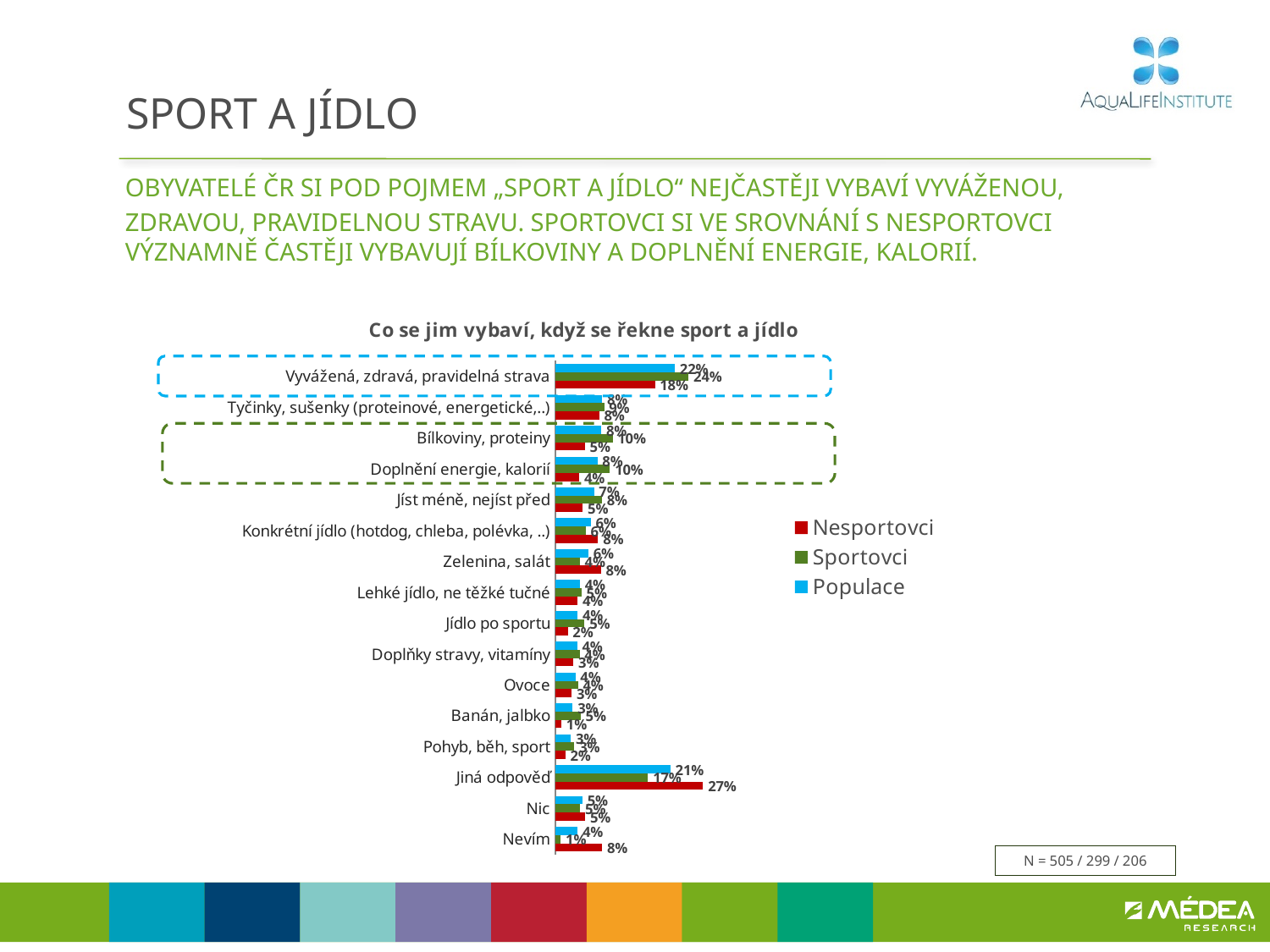
What is the Sportovci value for "Vyvážená, zdravá, pravidelná strava"? 24% What is the Nesportovci value for "Nevím"? 8% How many categories are plotted on the chart? 16 What is the Nesportovci value for "Jiná odpověď"? 27% What is the difference between the Nesportovci and Sportovci values for "Jiná odpověď"? 10% Which category has the highest Nesportovci value? Jiná odpověď What is the Populace value for "Vyvážená, zdravá, pravidelná strava"? 22% What kind of chart is shown on the slide? bar chart How many series does the legend list? 3 What is the difference between the Sportovci and Nesportovci values for "Bílkoviny, proteiny"? 5% Which is larger for "Doplnění energie, kalorií": the Sportovci value or the Nesportovci value? Sportovci Which series is shown in red in the legend? Nesportovci